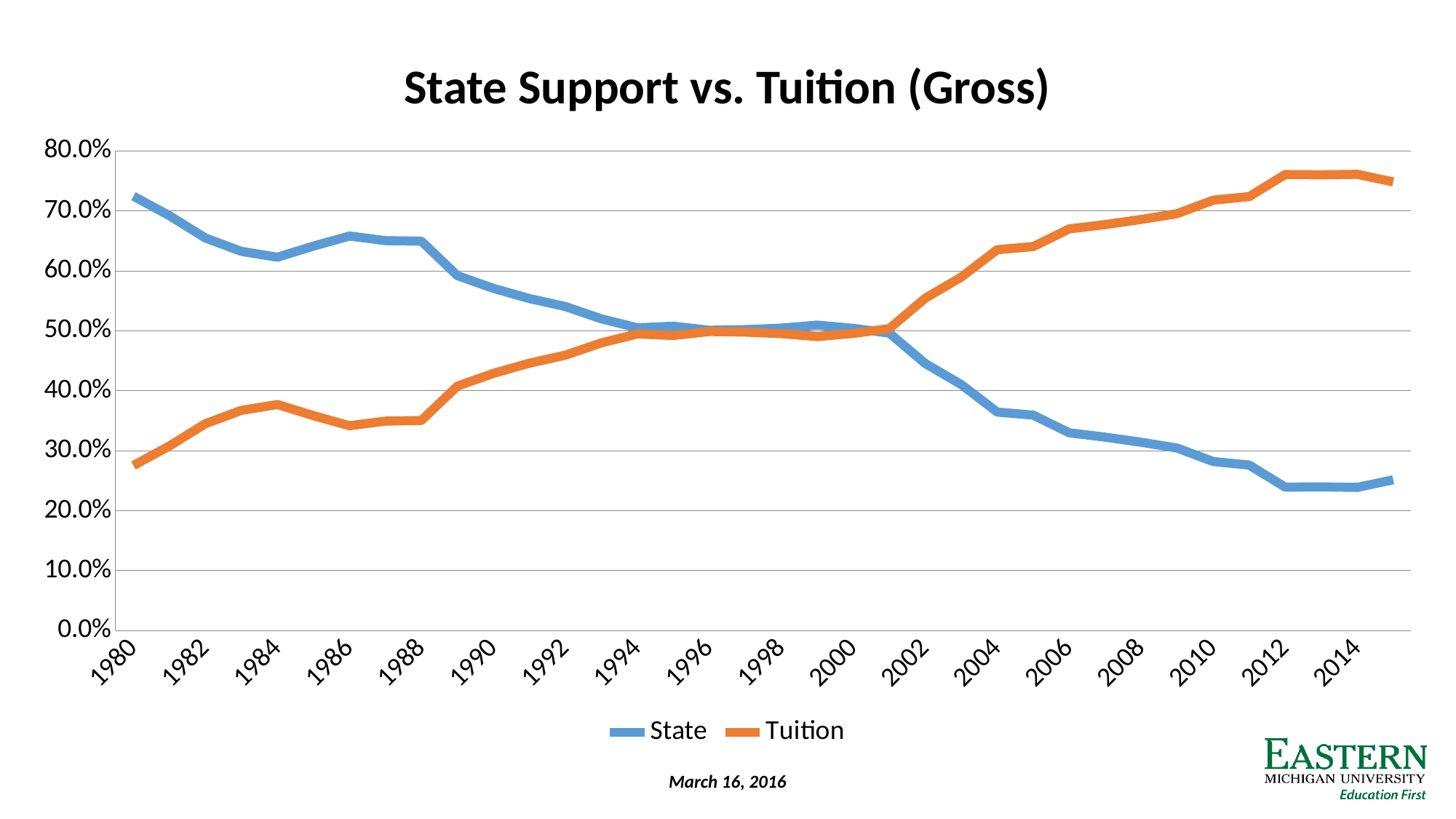
In 2010, which series has the higher value, State or Tuition? Tuition What kind of chart is shown on the slide? line chart Is the State value in 2012 greater or less than 30.0%? less Does the State series generally rise or fall from 1980 to 2014? fall Is the Tuition value in 1980 greater or less than 30.0%? less What is the title of the chart? State Support vs. Tuition (Gross) How many series does the legend list? 2 In 1990, which series has the higher value, State or Tuition? State Which series is drawn in orange? Tuition Is the State value in 1980 greater or less than 60.0%? greater